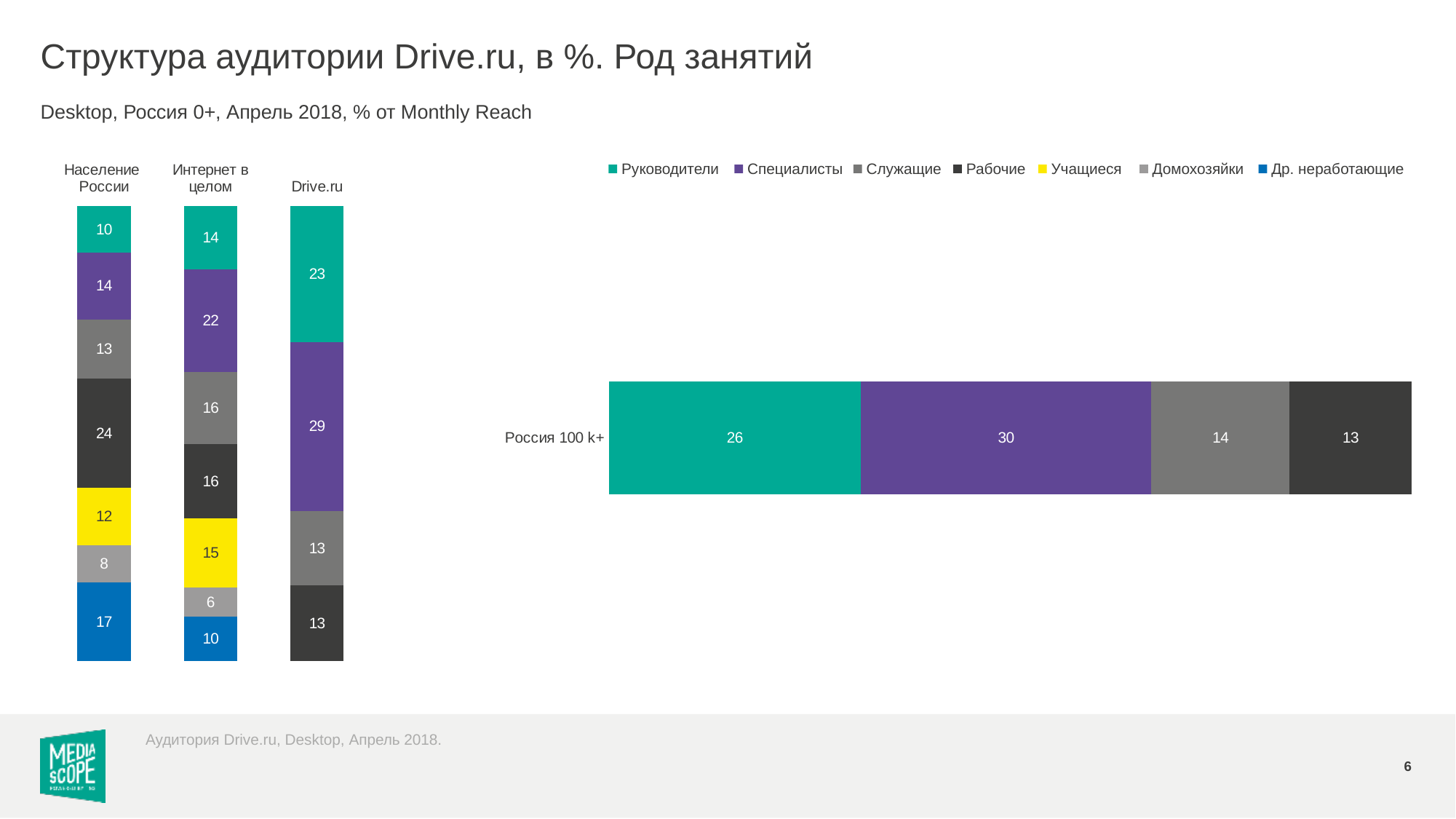
In the left chart, what is the value for Специалисты in the Drive.ru bar? 29 In the right chart, what is the value for Руководители for Россия 100 k+? 26 In the left chart, what is the value for Домохозяйки in the Интернет в целом bar? 6 How many bars are shown in the left chart? 3 How many series does the legend list? 7 In the left chart, which is larger: Специалисты for Интернет в целом or Специалисты for Drive.ru? Drive.ru In the left chart, what is the value for Рабочие in the Население России bar? 24 In the right chart, what is the total of the Россия 100 k+ bar? 83 In the left chart, what is the difference between the Руководители values for Drive.ru and Население России? 13 In the right chart, which segment of the Россия 100 k+ bar is the largest? Специалисты In the left chart, which segment of the Интернет в целом bar is the smallest? Домохозяйки What kind of chart is the right chart? Stacked bar chart